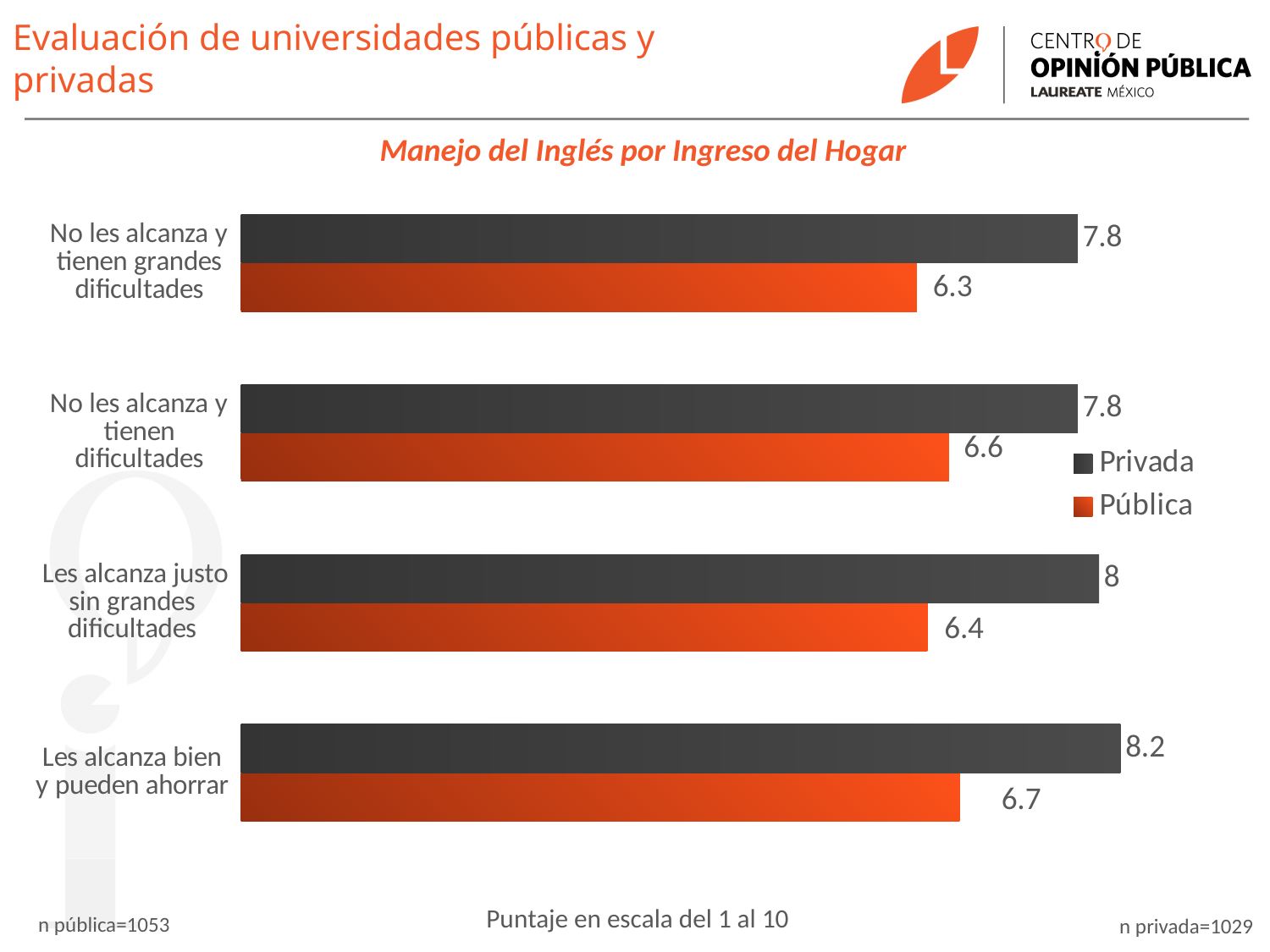
How many categories are shown on the chart? 4 What is the Pública value for 'No les alcanza y tienen grandes dificultades'? 6.3 Which is larger for 'No les alcanza y tienen dificultades', the Privada value or the Pública value? Privada What kind of chart is shown on the slide? Bar chart What is the difference between the Privada and Pública values for 'Les alcanza justo sin grandes dificultades'? 1.6 What is the Pública value for 'Les alcanza justo sin grandes dificultades'? 6.4 Which category has the highest Pública value? Les alcanza bien y pueden ahorrar What is the difference between the Privada and Pública values for 'Les alcanza bien y pueden ahorrar'? 1.5 Which category has the lowest Pública value? No les alcanza y tienen grandes dificultades How many series does the legend list? 2 What is the Privada value for 'No les alcanza y tienen dificultades'? 7.8 What is the Privada value for 'Les alcanza bien y pueden ahorrar'? 8.2